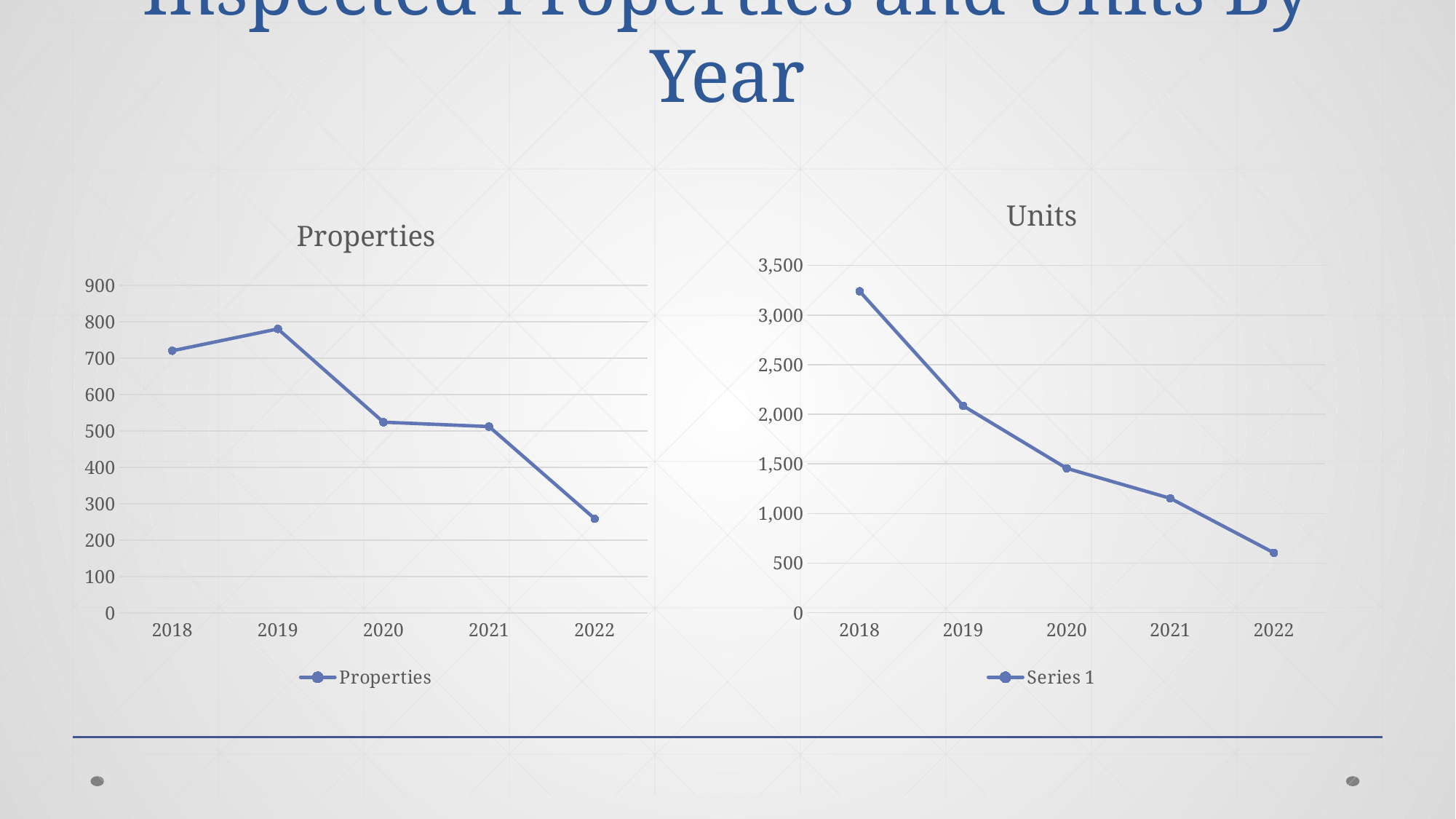
In the Properties chart, is the value for 2018 greater or less than 700? greater What is the legend entry shown on the Units chart? Series 1 In the Units chart, is the value for 2018 greater or less than 3,000? greater In the Properties chart, which is larger, the value for 2019 or the value for 2020? 2019 In the Units chart, do the values rise or fall from 2018 to 2022? fall In the Properties chart, is the value for 2022 greater or less than 300? less What kind of chart is the Properties chart? line chart In the Properties chart, which year has the highest value? 2019 How many years are plotted on the Units chart? 5 In the Properties chart, which year has the lowest value? 2022 In the Units chart, which year has the highest value? 2018